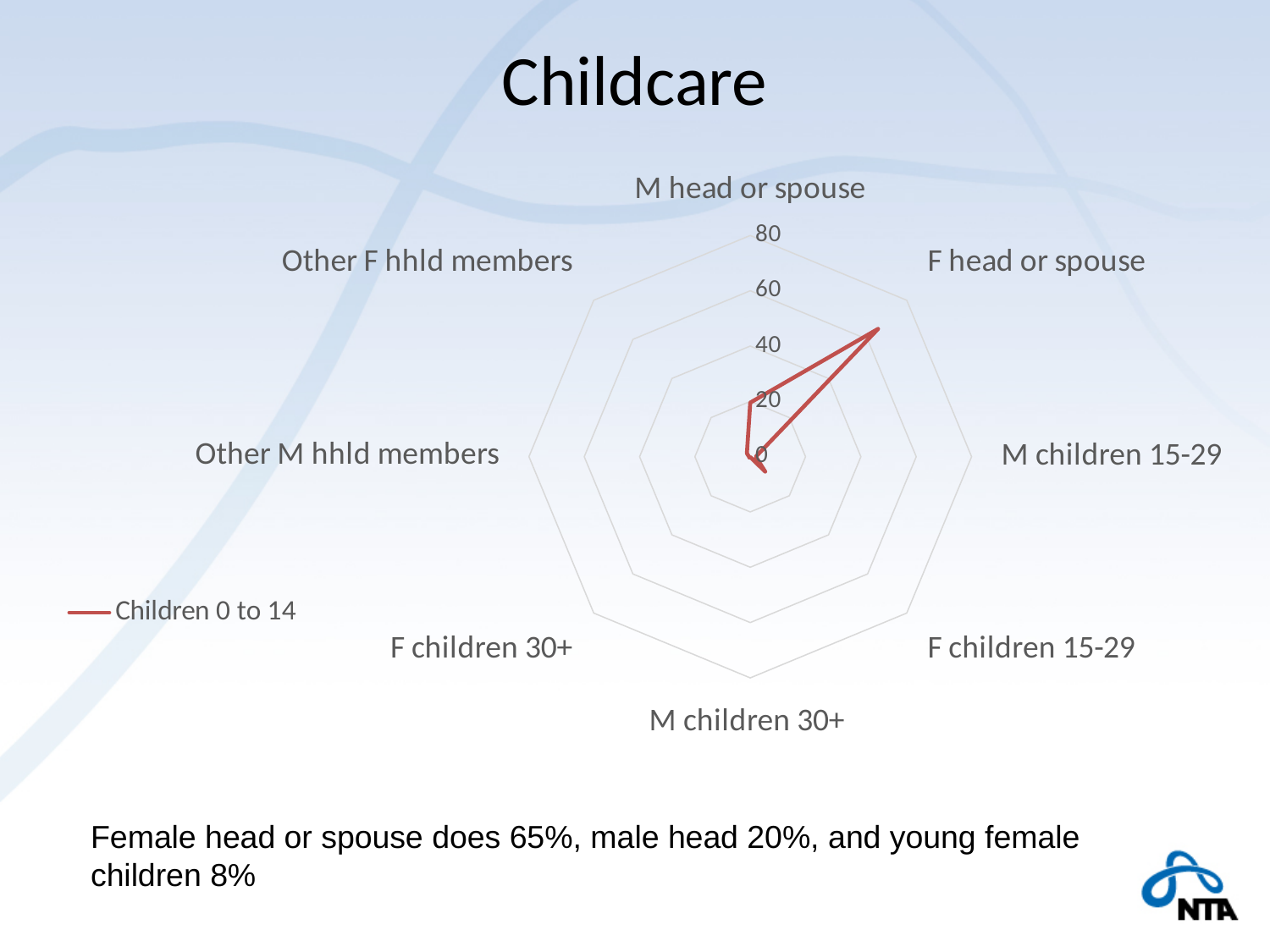
How many categories are plotted on the radar chart? 8 Is the value for M head or spouse greater or less than 40? less What is the title of the slide containing the chart? Childcare Which category has the highest value on the radar chart? F head or spouse How many series does the legend list? 1 Is the value for F head or spouse greater or less than 80? less What is the name of the series shown in the legend? Children 0 to 14 Is the value for M children 30+ greater or less than 20? less Which is larger, the value for F head or spouse or the value for M head or spouse? F head or spouse Which is larger, the value for M head or spouse or the value for M children 15-29? M head or spouse What kind of chart is shown on the slide? Radar chart